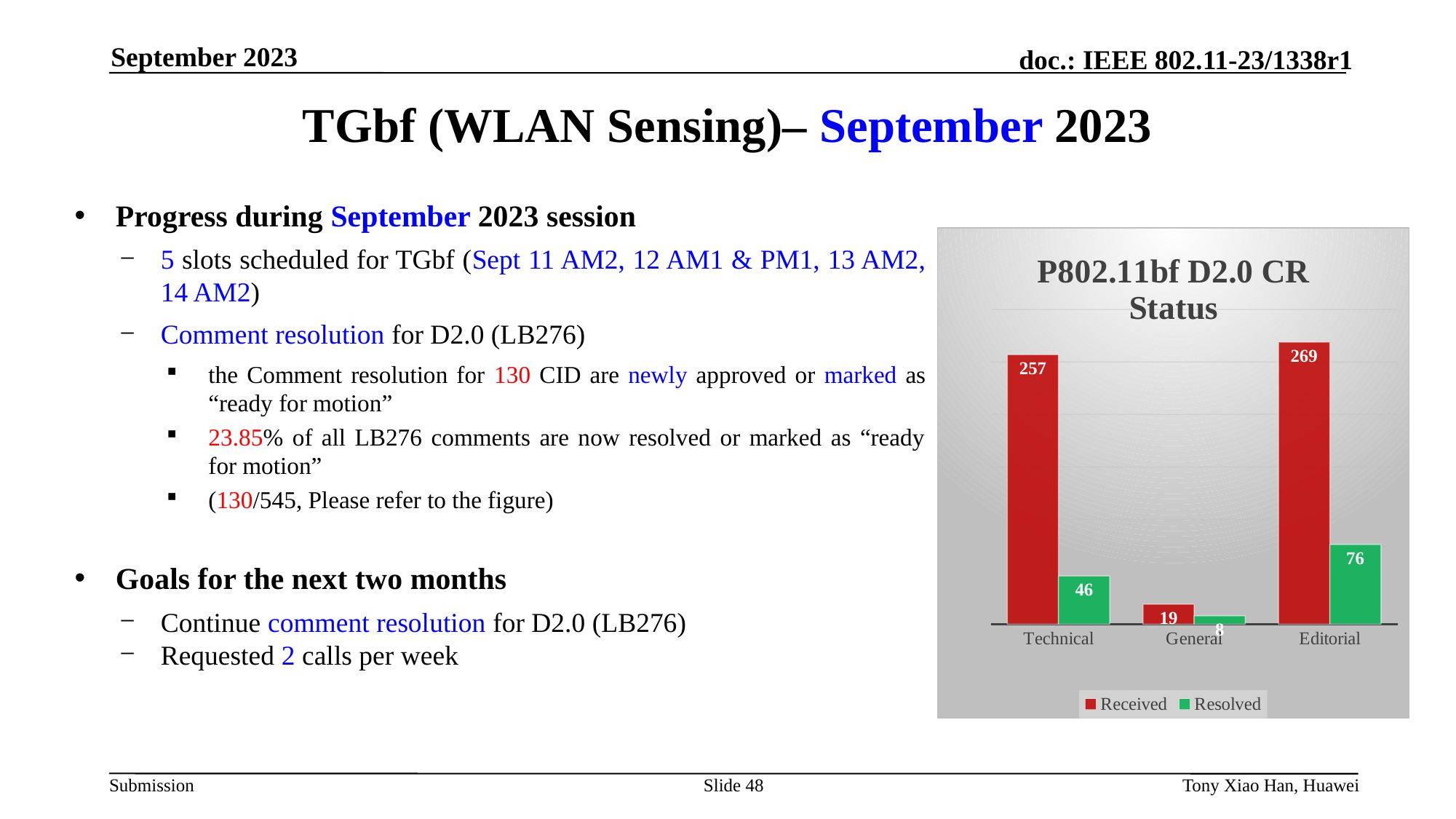
What is the Received value for Technical? 257 What is the difference between the Received values for Editorial and Technical? 12 How many categories are shown on the x axis of the chart? 3 What is the title of the chart? P802.11bf D2.0 CR Status Which series is shown in green in the chart? Resolved What type of chart is shown on the slide? bar chart What is the Received value for General? 19 How many series does the chart legend list? 2 Which category has the highest Received value? Editorial Is the Resolved value for Technical larger or smaller than the Resolved value for Editorial? smaller What is the Resolved value for Editorial? 76 Which category has the lowest Resolved value? General